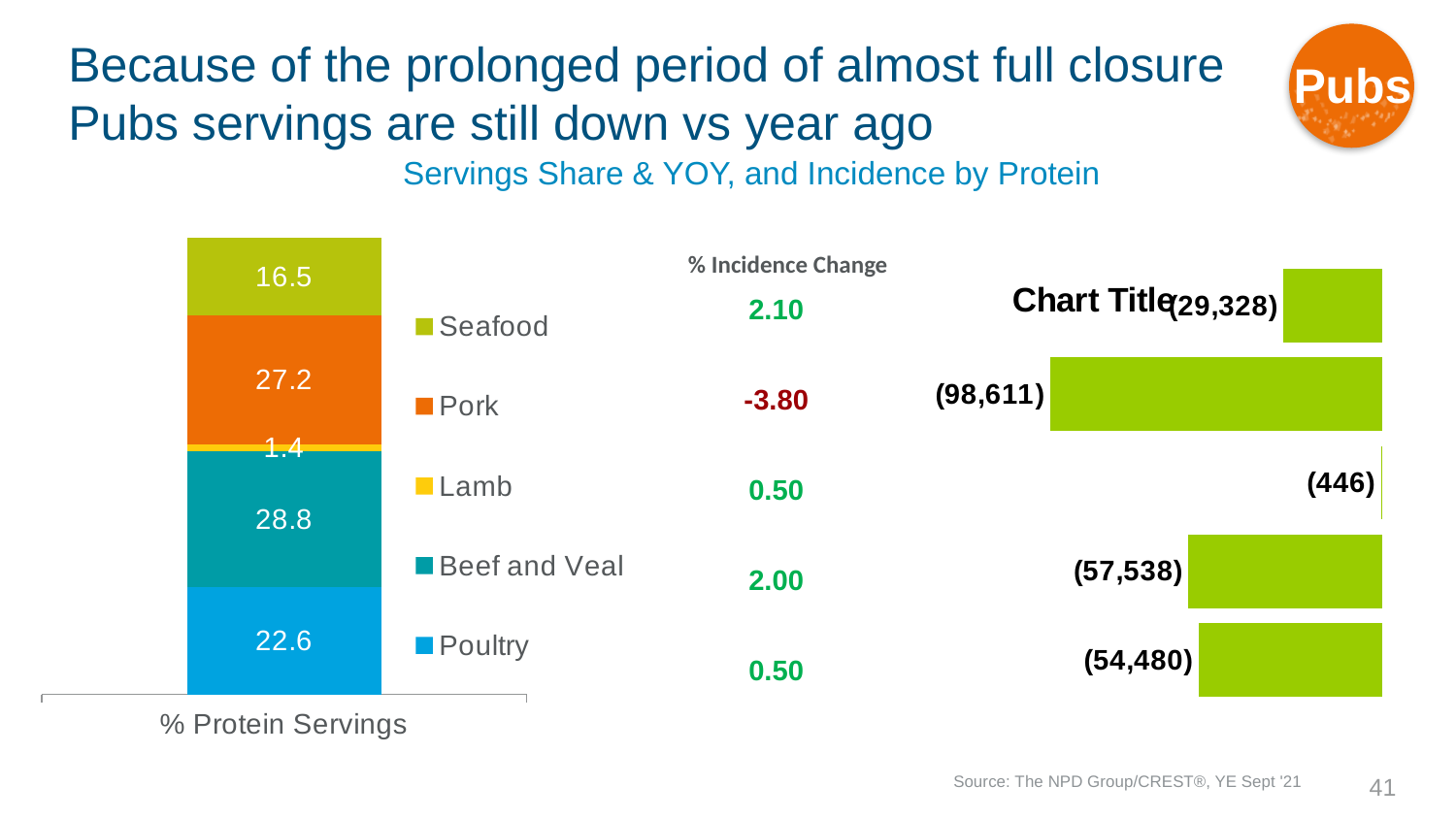
In the left stacked bar chart (% Protein Servings), what is the value for Pork? 27.2 How many series does the legend of the left stacked bar chart list? 5 In the left stacked bar chart (% Protein Servings), which is larger, the Seafood value or the Poultry value? Poultry In the left stacked bar chart (% Protein Servings), which protein has the largest share? Beef and Veal In the left stacked bar chart (% Protein Servings), what is the value for Poultry? 22.6 What type of chart is the chart on the right of the slide titled 'Chart Title'? Bar chart In the left stacked bar chart (% Protein Servings), what is the value for Lamb? 1.4 In the left stacked bar chart (% Protein Servings), what is the difference between the Pork and Seafood values? 10.7 What is the total of the stacked bar in the left chart (% Protein Servings)? 96.5 In the left stacked bar chart (% Protein Servings), which protein has the smallest share? Lamb In the right chart titled 'Chart Title', what is the value shown on the second bar from the top? (98,611) How many bars are in the right chart titled 'Chart Title'? 5